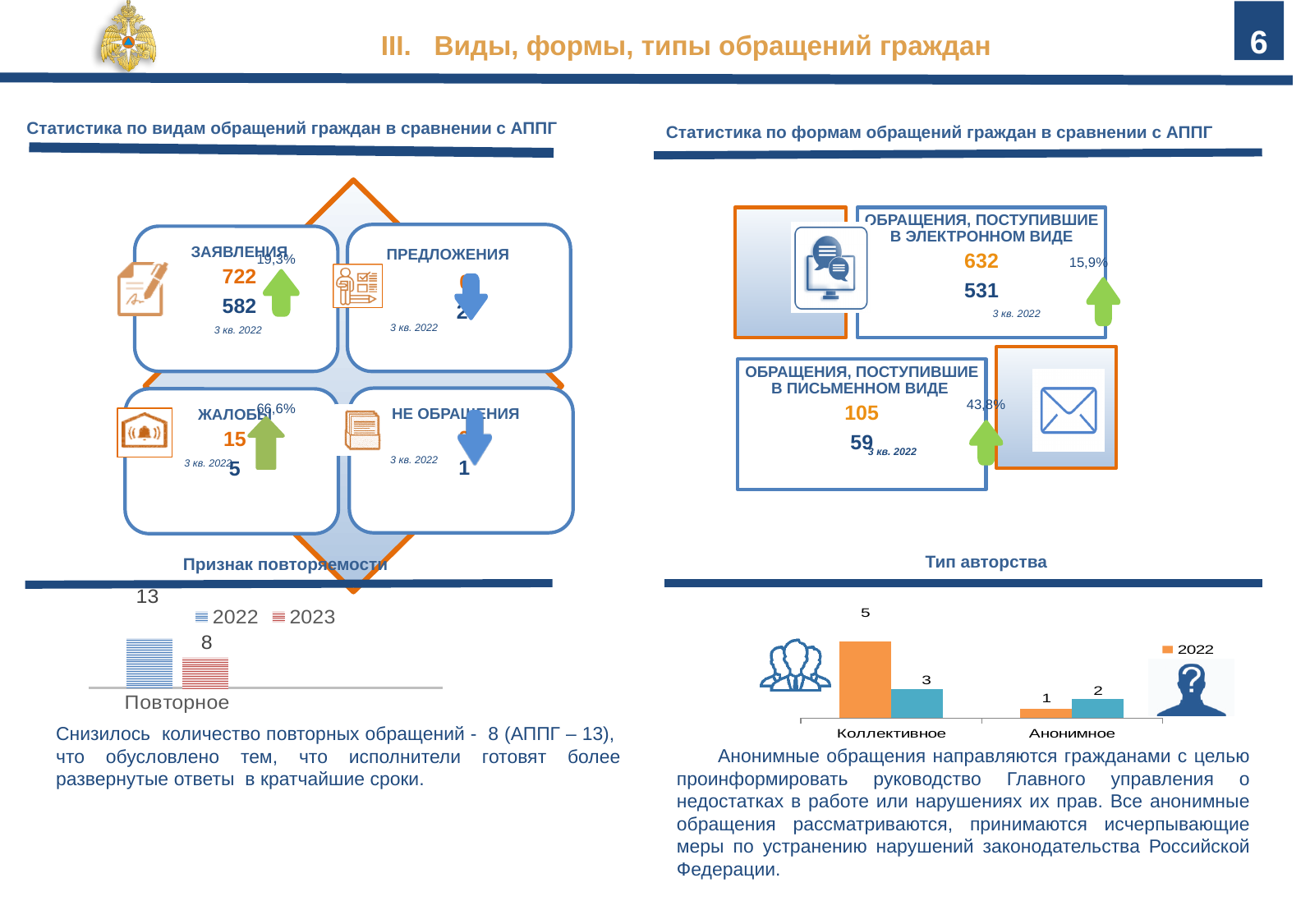
What kind of chart is the 'Признак повторяемости' chart? bar chart In the 'Тип авторства' chart, what is the value of the blue bar for 'Коллективное'? 3 In the 'Признак повторяемости' chart, what is the value for 2022 for 'Повторное'? 13 In the 'Признак повторяемости' chart, what is the value for 2023 for 'Повторное'? 8 In the 'Признак повторяемости' chart, which series has the larger value for 'Повторное', 2022 or 2023? 2022 How many series does the legend of the 'Признак повторяемости' chart list? 2 In the 'Тип авторства' chart, what is the value of the blue bar for 'Анонимное'? 2 In the 'Тип авторства' chart, which category has the higher 2022 value? Коллективное In the 'Тип авторства' chart, what is the 2022 value for 'Анонимное'? 1 In the 'Тип авторства' chart, what is the 2022 value for 'Коллективное'? 5 In the 'Признак повторяемости' chart, what is the difference between the 2022 and 2023 values for 'Повторное'? 5 How many categories are shown on the x axis of the 'Тип авторства' chart? 2